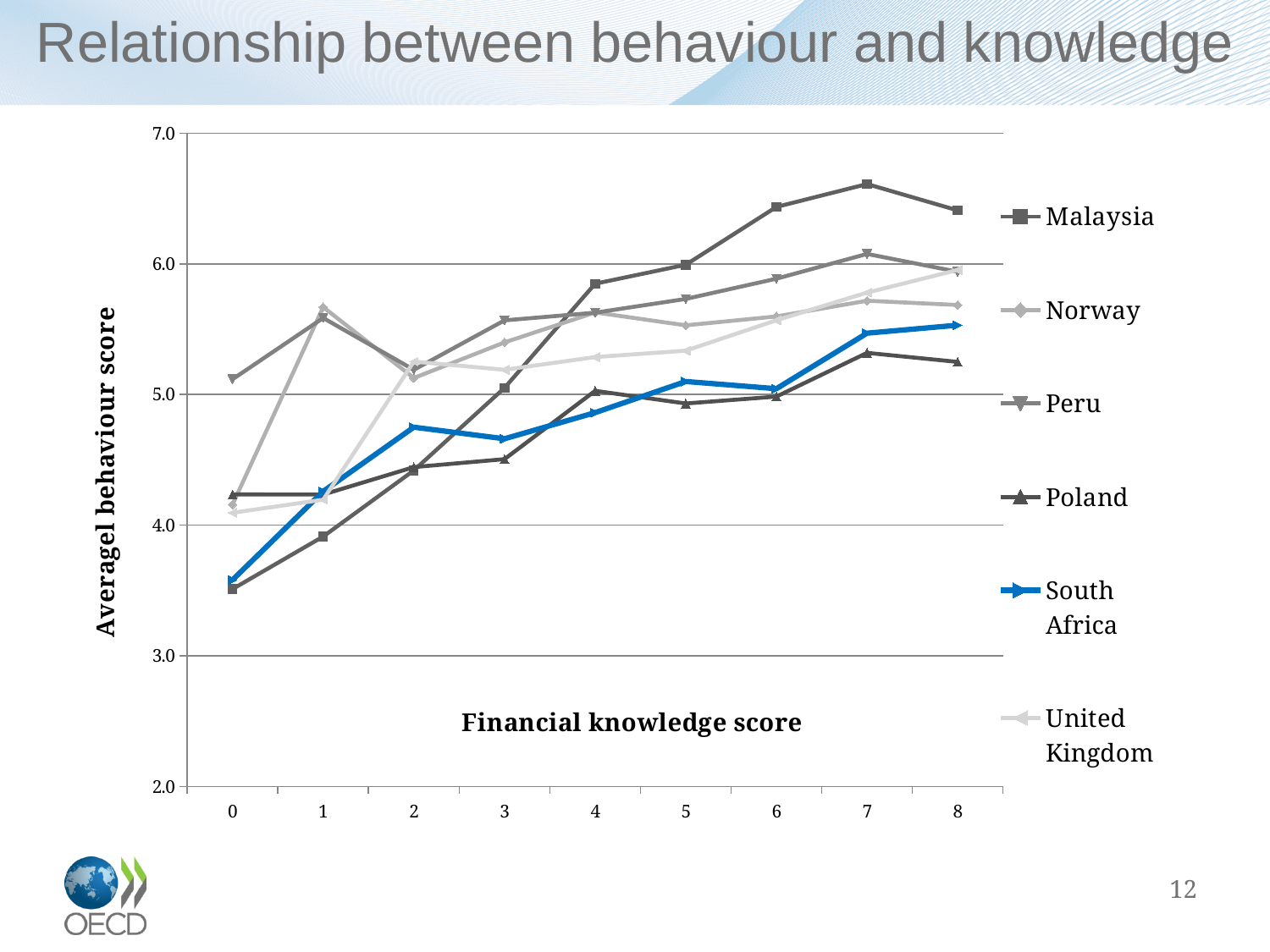
What kind of chart is shown on the slide? line chart Which country has the highest average behaviour score at a financial knowledge score of 0? Peru At a financial knowledge score of 8, which is larger: the value for Malaysia or the value for Poland? Malaysia Is the value for Malaysia at a financial knowledge score of 0 greater or less than 4.0? less Which country has the lowest average behaviour score at a financial knowledge score of 8? Poland How many series does the legend list? 6 Which country has the highest average behaviour score at a financial knowledge score of 8? Malaysia Is the value for Poland at a financial knowledge score of 8 greater or less than 5.0? greater Is the value for Malaysia at a financial knowledge score of 7 greater or less than 6.0? greater Which country is drawn with the blue line? South Africa Does the Malaysia line rise or fall between financial knowledge scores 0 and 7? rises How many financial knowledge score values are shown along the x axis? 9